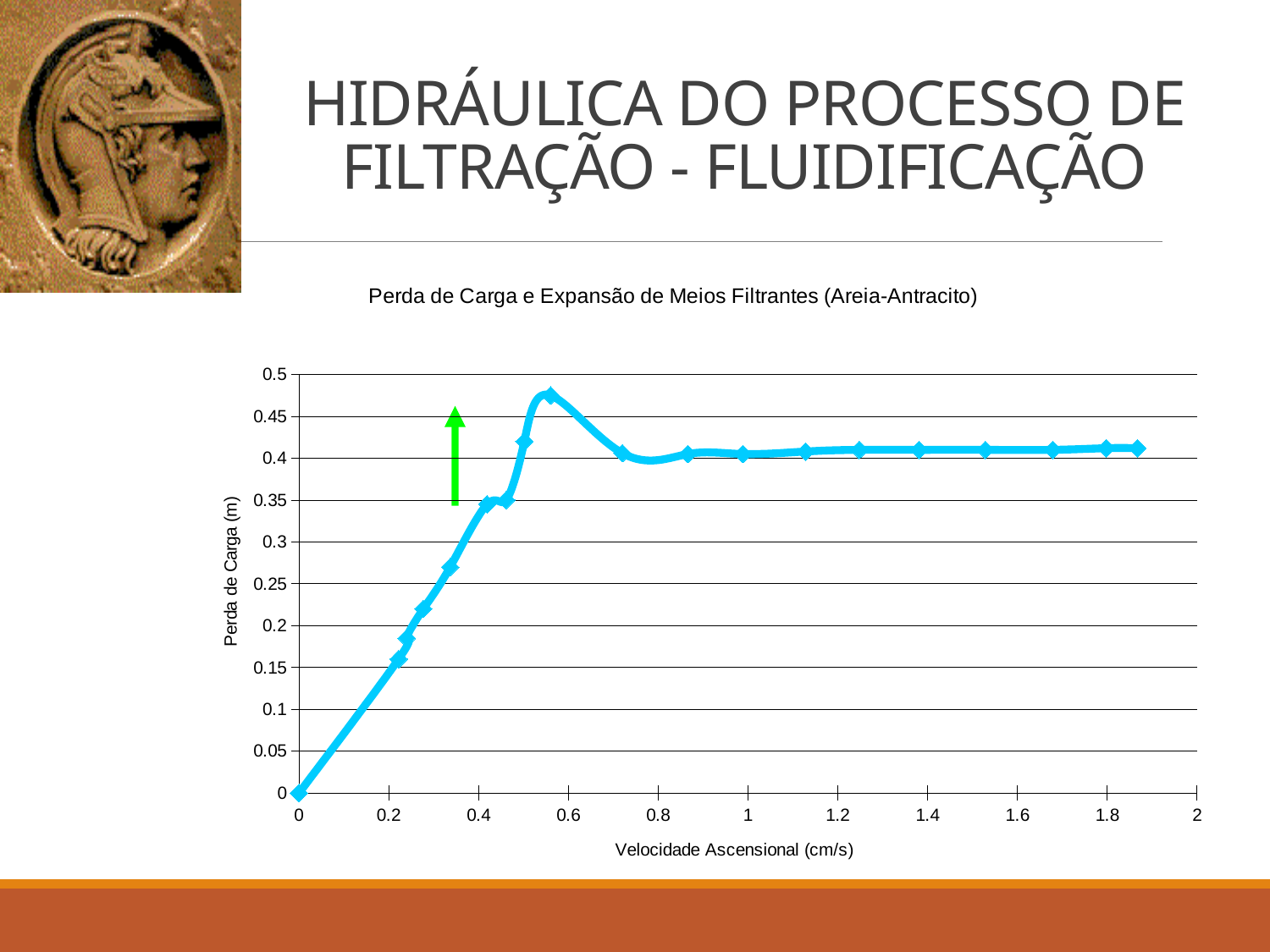
What is the title of the chart? Perda de Carga e Expansão de Meios Filtrantes (Areia-Antracito) Is the Perda de Carga value at a Velocidade Ascensional of 1.8 cm/s greater or less than 0.45? less Which is larger: the Perda de Carga at 0.2 cm/s or at 1.8 cm/s? 1.8 cm/s What kind of chart is shown on the slide? Line chart Is the Perda de Carga value at a Velocidade Ascensional of 0.2 cm/s greater or less than 0.1? greater Does the Perda de Carga rise or fall as Velocidade Ascensional increases from 0 to 0.5 cm/s? Rises Is the Perda de Carga value at a Velocidade Ascensional of 1 cm/s greater or less than 0.35? greater What is the Perda de Carga value at a Velocidade Ascensional of 0 cm/s? 0 What is the label of the x axis of the chart? Velocidade Ascensional (cm/s)